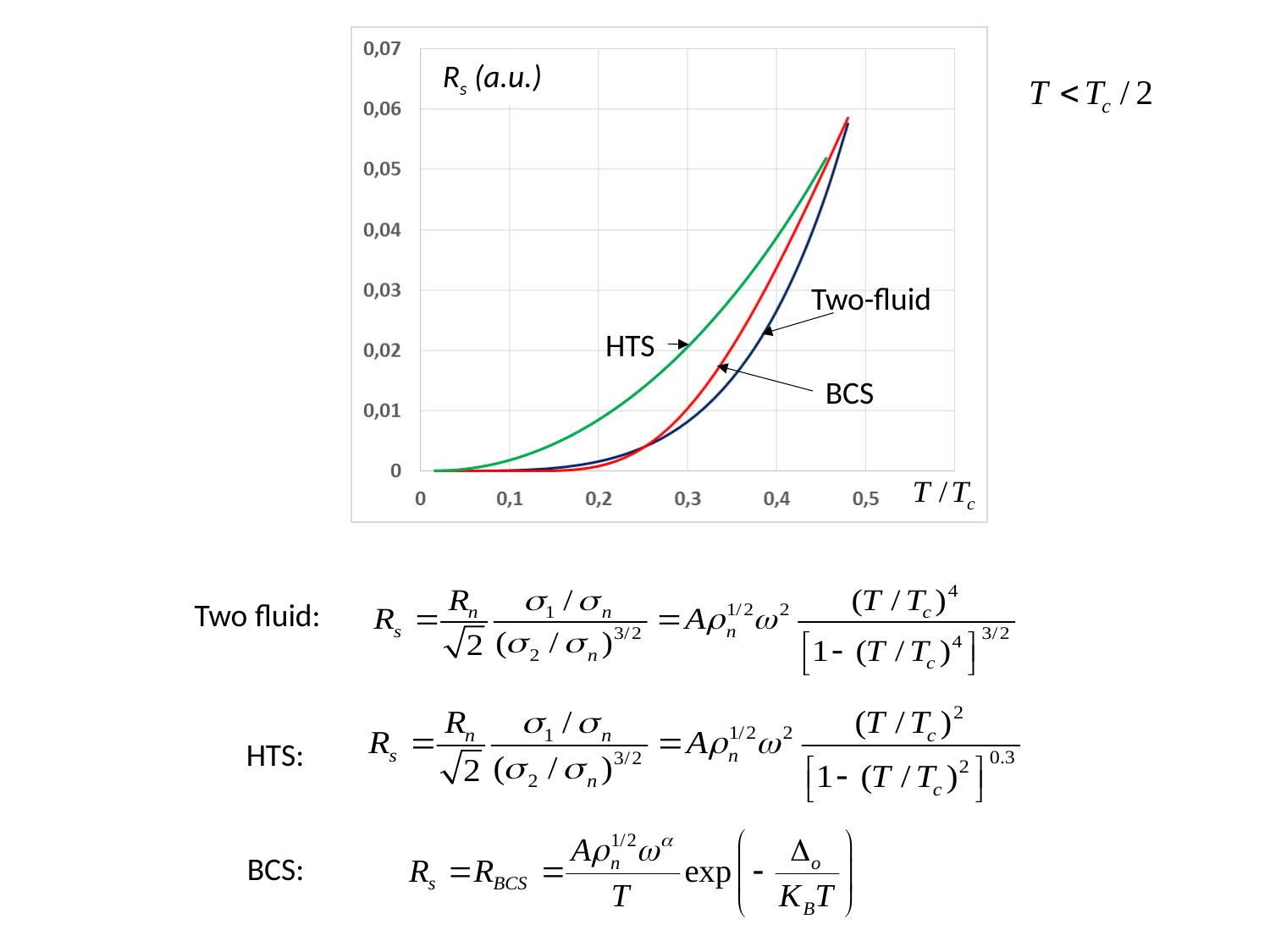
At T/Tc = 0.4, which is larger, the BCS curve or the Two-fluid curve? BCS Do the curves rise or fall as T/Tc increases? rise At T/Tc = 0.3, which curve has the highest Rs value? HTS At T/Tc = 0.3, which is larger, the HTS curve or the BCS curve? HTS At T/Tc = 0.3, is the Two-fluid curve greater or less than 0.01? less At T/Tc = 0.3, is the HTS curve greater or less than 0.01? greater At T/Tc = 0.4, is the Two-fluid curve greater or less than 0.03? less What is the label of the vertical axis? Rs (a.u.) Which curves are labelled on the chart? HTS, Two-fluid, BCS What kind of chart is shown on the slide? line chart How many curves are plotted on the chart? 3